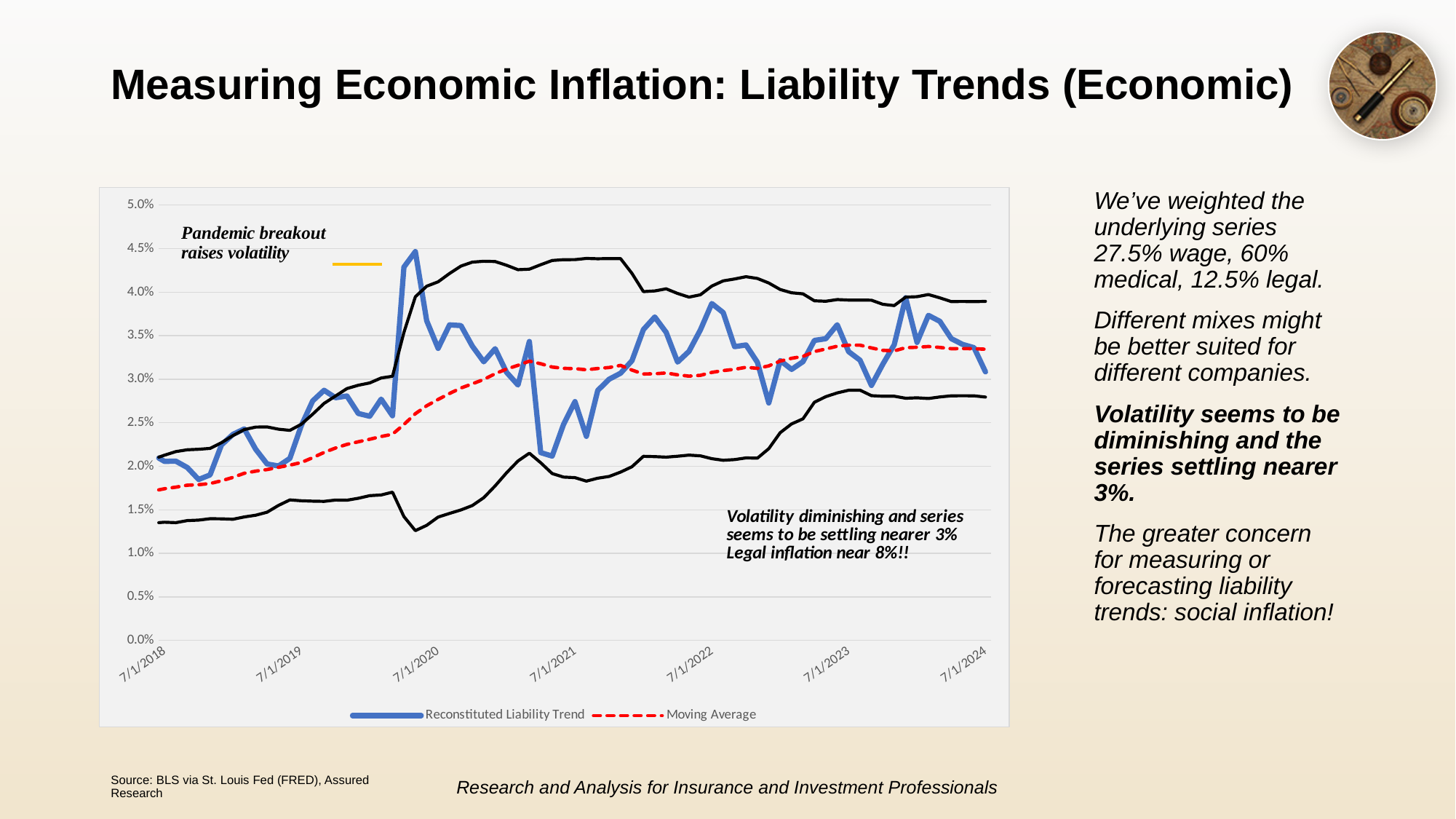
Is the Reconstituted Liability Trend value at 7/1/2018 greater or less than 2.5%? less How many series does the chart legend list? 2 What are the two series named in the chart legend? Reconstituted Liability Trend and Moving Average Is the Moving Average value at 7/1/2024 greater or less than 3.0%? greater How many date labels are shown on the x axis? 7 Which series in the legend is drawn as a red dashed line? Moving Average Is the highest value reached by the Reconstituted Liability Trend greater or less than 4.0%? greater Does the Moving Average generally rise or fall from 7/1/2018 to 7/1/2024? rise Which is larger: the Moving Average value at 7/1/2018 or at 7/1/2024? 7/1/2024 What kind of chart is shown on the slide? line chart